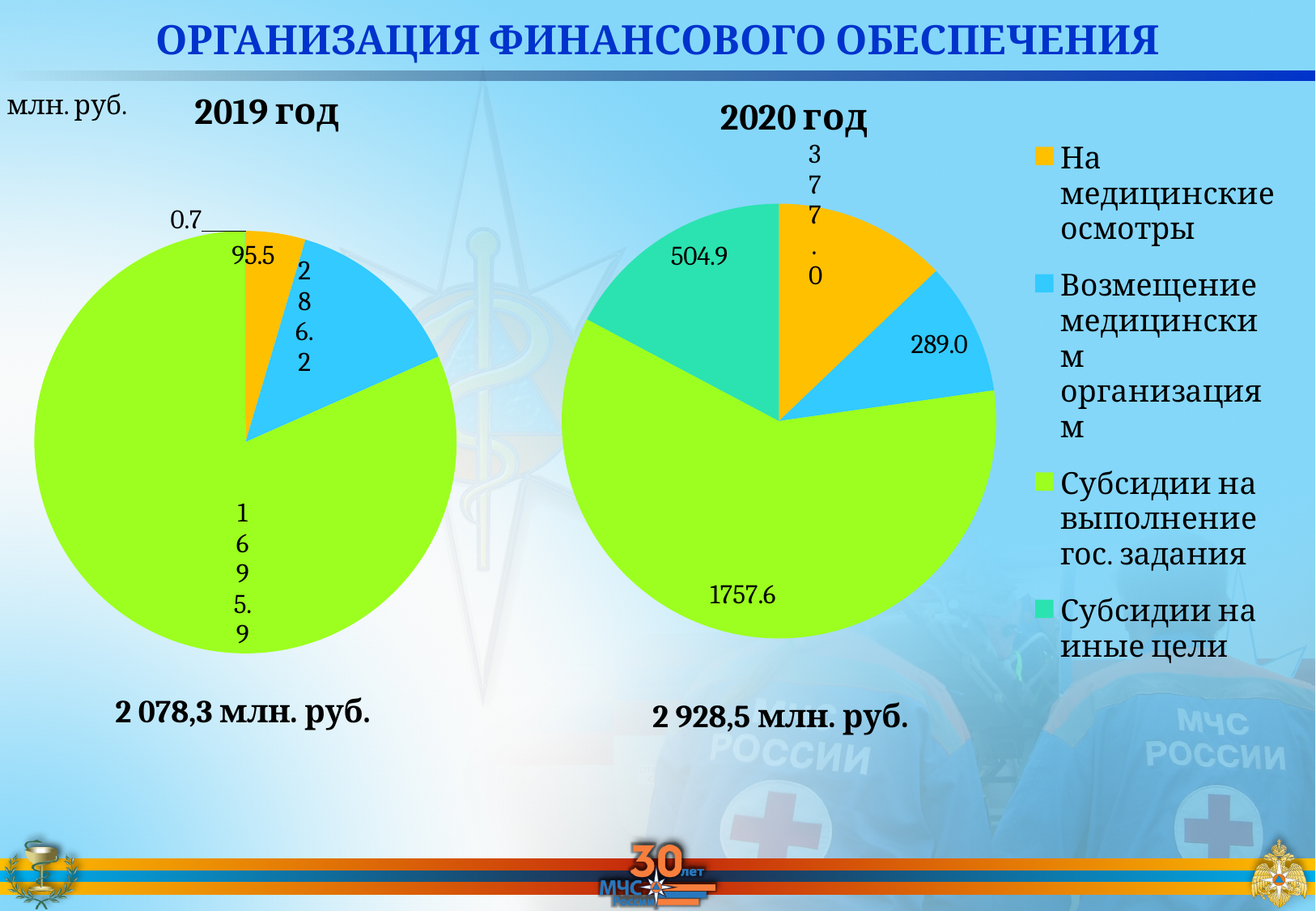
How many slices does the 2020 год pie chart have? 4 What is the difference between the value for Субсидии на выполнение гос. задания on the 2020 год chart and on the 2019 год chart? 61.7 On the 2019 год pie chart, what is the value for На медицинские осмотры? 95.5 On the 2020 год pie chart, which is larger: Субсидии на иные цели or На медицинские осмотры? Субсидии на иные цели On the 2020 год pie chart, which category has the largest value? Субсидии на выполнение гос. задания On the 2019 год pie chart, what is the value for Субсидии на выполнение гос. задания? 1695.9 What is the difference between the value for На медицинские осмотры on the 2020 год chart and on the 2019 год chart? 281.5 What type of chart is used for 2019 год? Pie chart On the 2020 год pie chart, what is the value for Субсидии на иные цели? 504.9 On the 2019 год pie chart, which category has the smallest value? Субсидии на иные цели On the 2020 год pie chart, what is the value for Возмещение медицинским организациям? 289.0 What total is printed below the 2020 год pie chart? 2 928,5 млн. руб.